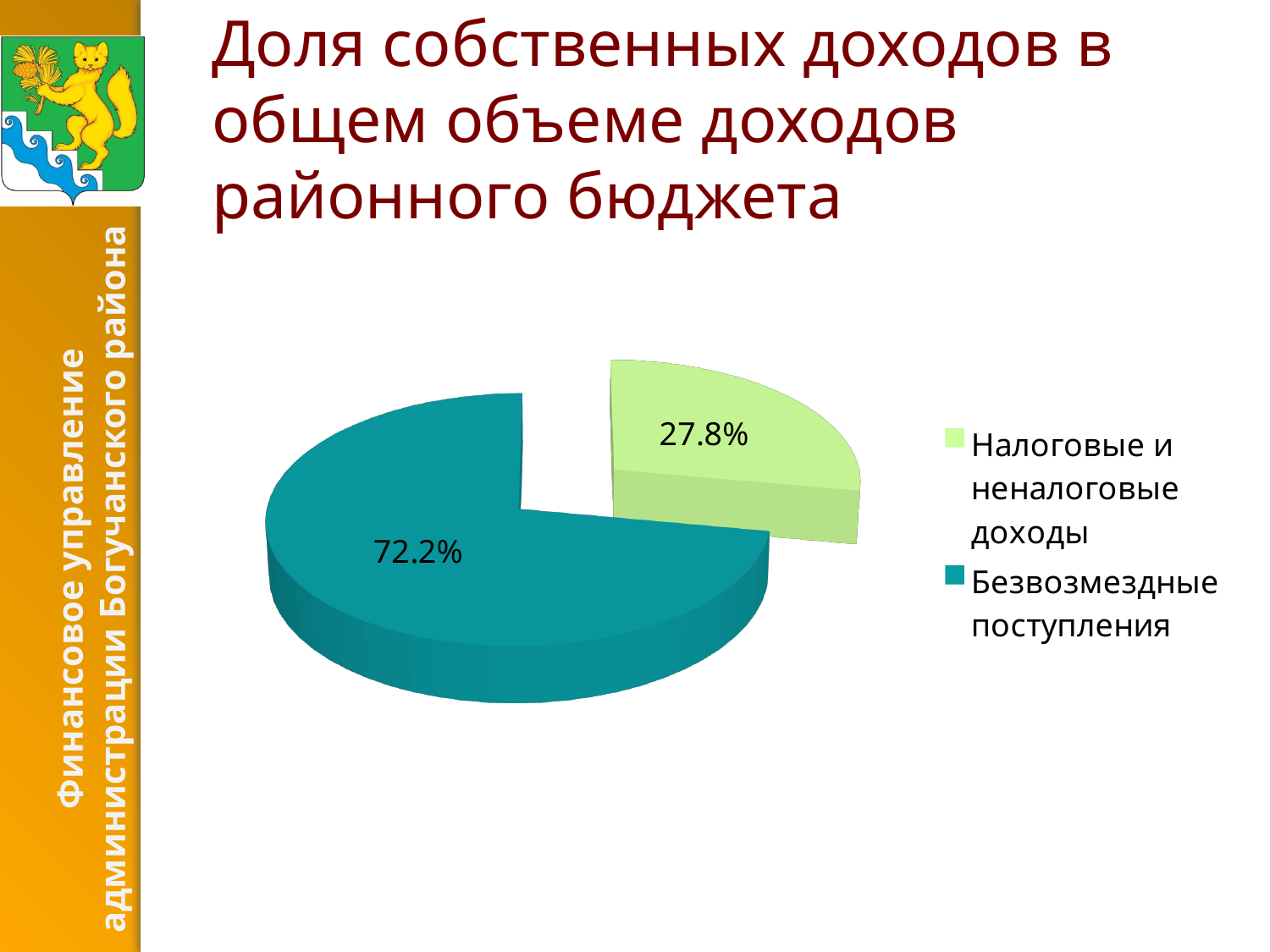
What share of the pie is labelled for "Налоговые и неналоговые доходы"? 27.8% Which slice of the pie is the smallest? Налоговые и неналоговые доходы Which slice is pulled out (exploded) from the pie? Налоговые и неналоговые доходы How many entries does the legend list? 2 How many slices does the pie chart have? 2 Which is larger: the share for "Налоговые и неналоговые доходы" or the share for "Безвозмездные поступления"? Безвозмездные поступления Which slice of the pie is the largest? Безвозмездные поступления What colour is the slice for "Безвозмездные поступления"? teal What is the difference in percentage points between the "Безвозмездные поступления" slice and the "Налоговые и неналоговые доходы" slice? 44.4 What kind of chart is shown on the slide? pie chart What share of the pie is labelled for "Безвозмездные поступления"? 72.2%